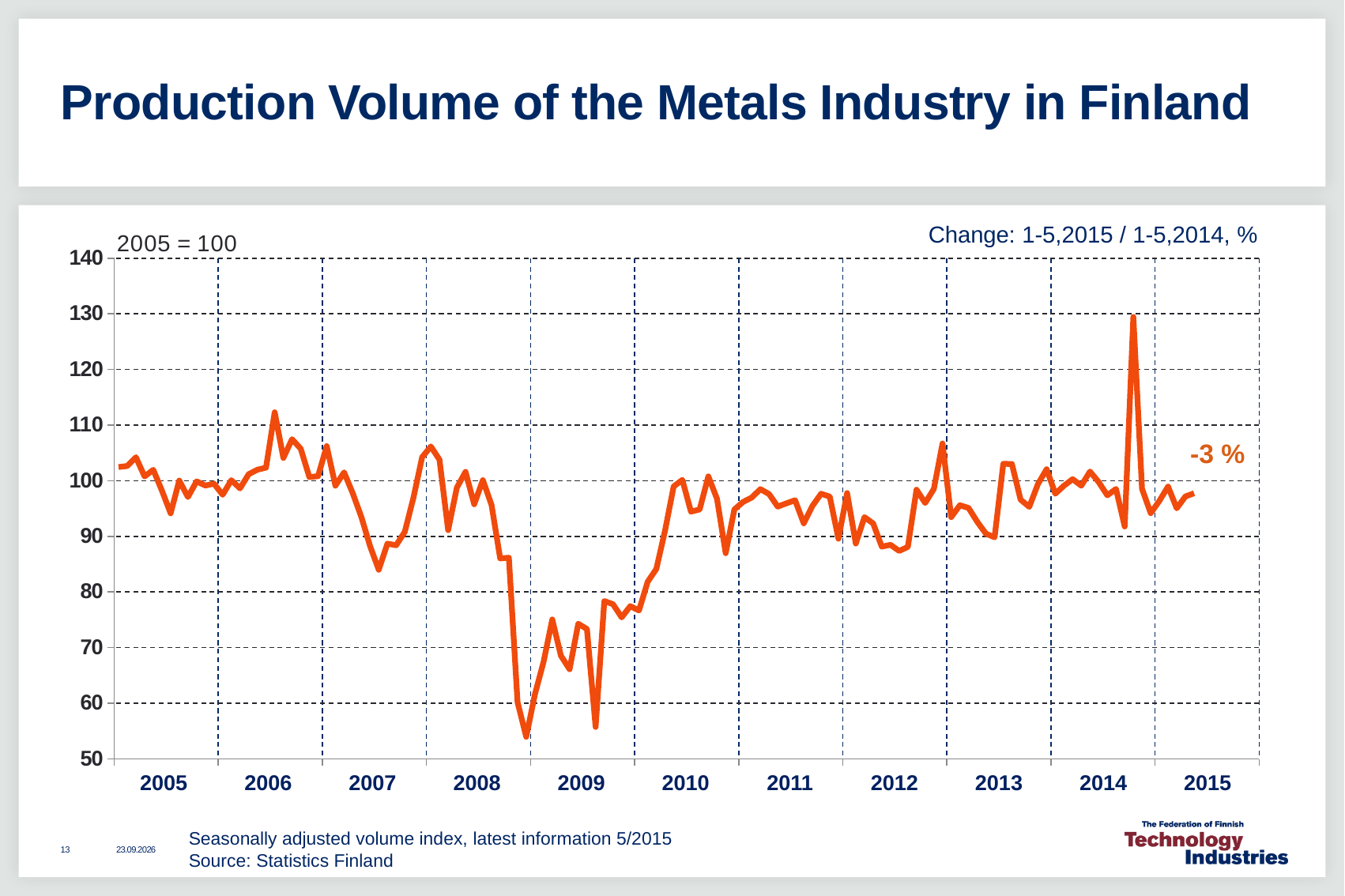
Is the value of the index at the start of 2005 greater or less than 100? greater What is the highest value shown on the y axis? 140 Is the peak value of the spike in 2014 greater or less than 120? greater Does the index rise or fall between the start of 2009 and the start of 2010? rise Does the index rise or fall between the start of 2008 and the end of 2008? fall What is the percentage change for 1-5,2015 / 1-5,2014 shown on the chart? -3 % In which year does the line reach its highest point? 2014 What kind of chart is shown on the slide? line chart How many year labels are shown on the x axis? 11 What is the title of the chart? Production Volume of the Metals Industry in Finland What is the source of the data cited on the slide? Statistics Finland Is the lowest value of the index in late 2008 greater or less than 60? less